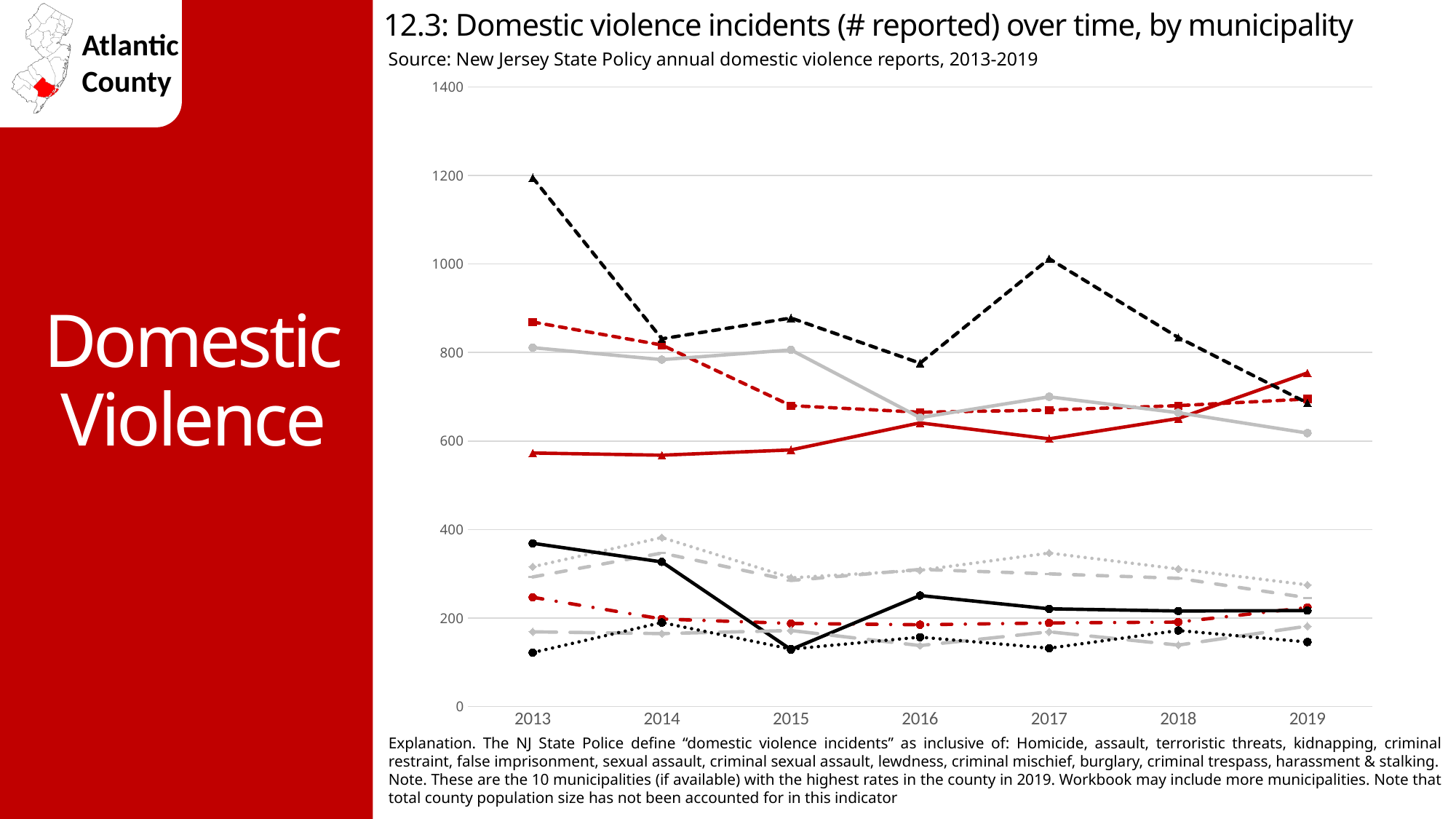
Is the lowest value plotted in 2013 greater or less than 200? less What is the title of the chart? 12.3: Domestic violence incidents (# reported) over time, by municipality Is the highest value plotted in 2019 greater or less than 800? less Does the line that starts highest in 2013 rise or fall between 2013 and 2014? fall Is the lowest value plotted in 2019 greater or less than 200? less How many years are shown along the x axis of the chart? 7 What is the highest value shown on the chart's y axis? 1400 How many municipality lines are plotted on the chart? 10 What type of chart is shown on the slide? line chart In which year does the single highest plotted value on the chart occur? 2013